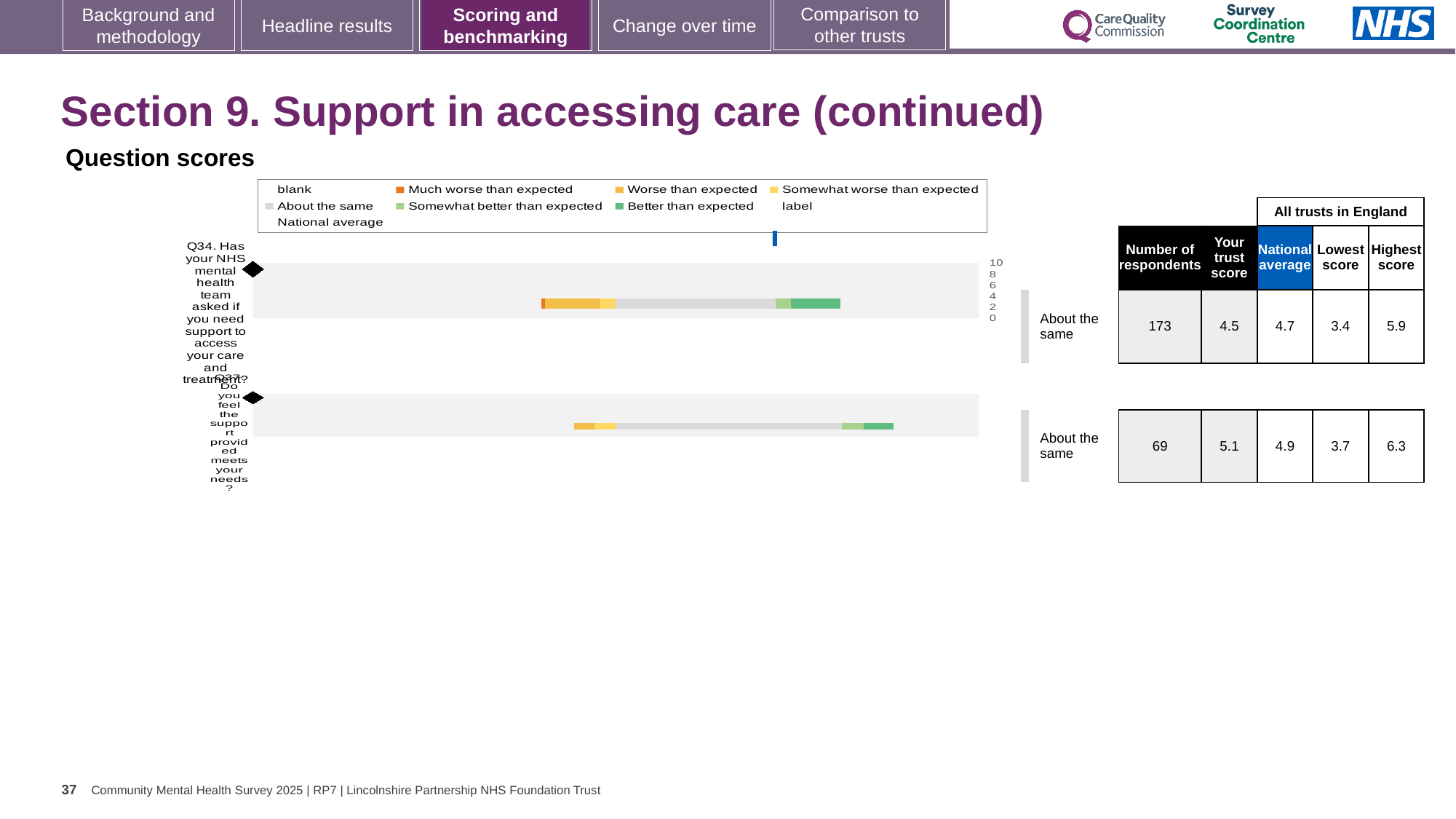
What is the difference between the trust scores for Q37 and Q34? 0.6 According to the table beside the chart, what is the trust score for Q37? 5.1 According to the table beside the chart, what is the trust score for Q34? 4.5 Which question is plotted in the top bar of the chart? Q34 How many questions (bars) are plotted in the chart? 2 According to the table beside the chart, what is the national average for Q34? 4.7 According to the table beside the chart, how many respondents answered Q37? 69 Which question has the higher trust score, Q34 or Q37? Q37 Which question has the higher 'Highest score' across all trusts in England? Q37 What colour in the legend represents 'Better than expected'? green What kind of chart is shown under 'Question scores'? bar chart What is the benchmark category shown next to the bar for Q34? About the same